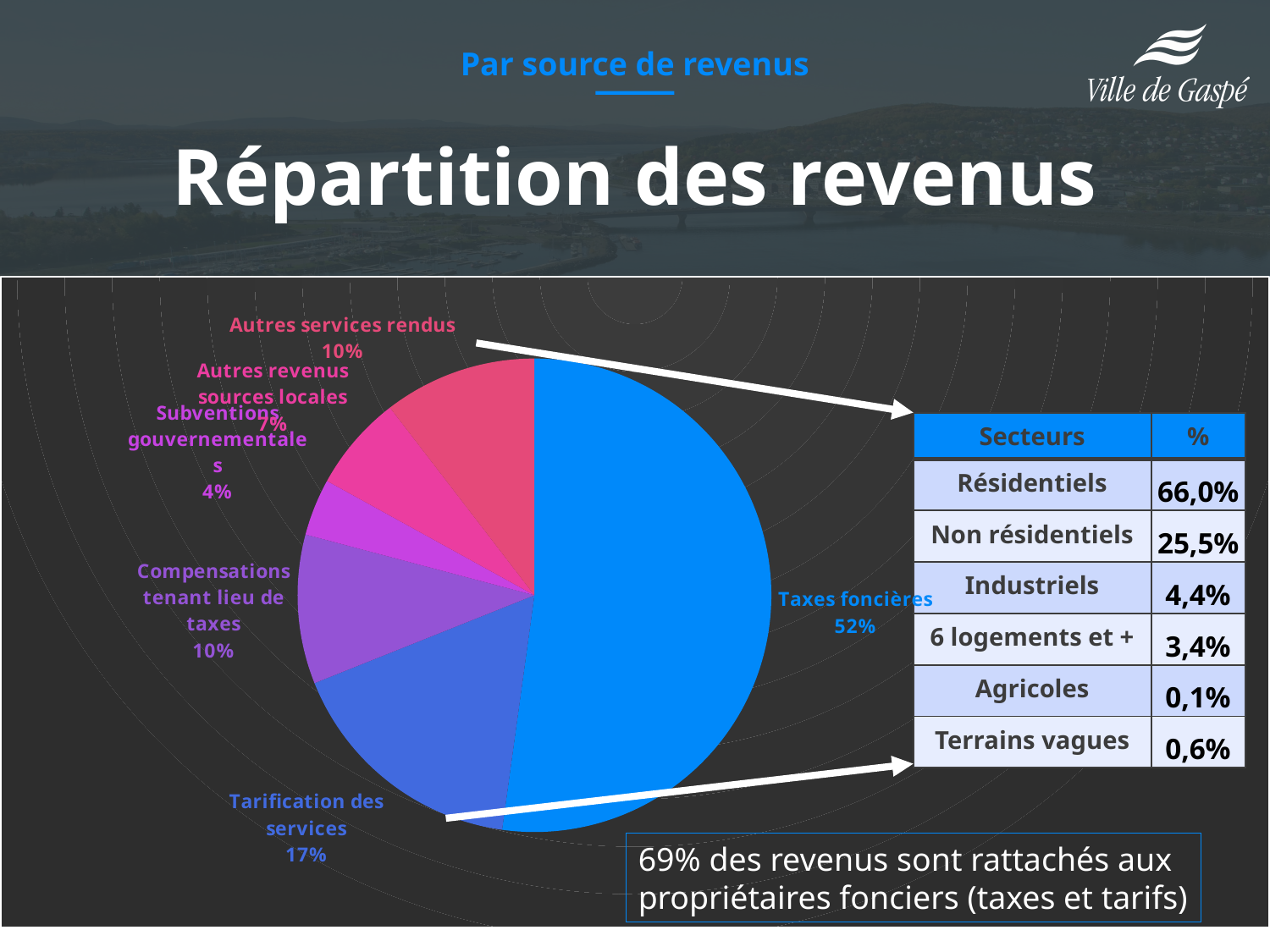
What share of revenues comes from Compensations tenant lieu de taxes? 10% What type of chart is shown on the slide? pie chart What share of revenues comes from Taxes foncières? 52% What share of revenues comes from Autres revenus sources locales? 7% What share of revenues comes from Tarification des services? 17% How many slices does the pie chart have? 6 What is the combined share of Taxes foncières and Tarification des services? 69% What share of revenues comes from Subventions gouvernementales? 4% Which is larger, Autres services rendus or Autres revenus sources locales? Autres services rendus Which revenue source has the largest slice of the pie? Taxes foncières Which revenue source has the smallest slice of the pie? Subventions gouvernementales What is the difference in percentage points between Taxes foncières and Tarification des services? 35